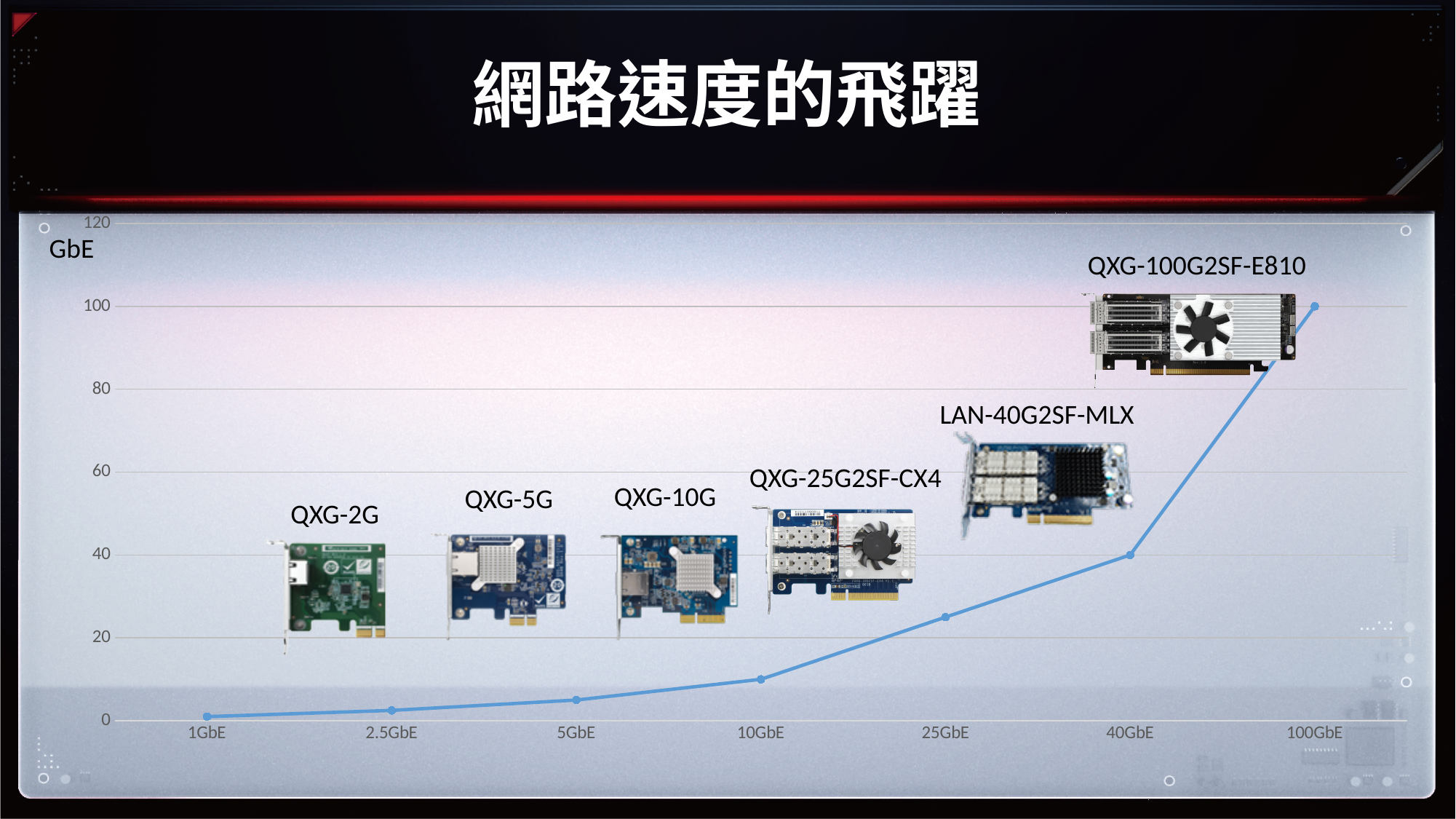
Do the values rise or fall moving from 1GbE to 100GbE along the x axis? rise What is the difference between the values plotted for 100GbE and 40GbE? 60 What is the value plotted for 40GbE? 40 Which product name is labelled next to the 40GbE point? LAN-40G2SF-MLX Which category has the highest plotted value? 100GbE Which is larger, the value for 40GbE or the value for 25GbE? 40GbE What is the value plotted for 100GbE? 100 Which category has the lowest plotted value? 1GbE Is the value for 10GbE greater or less than 20? less How many data points are plotted on the line? 7 What kind of chart is shown on the slide? line chart Is the value for 25GbE greater or less than 40? less